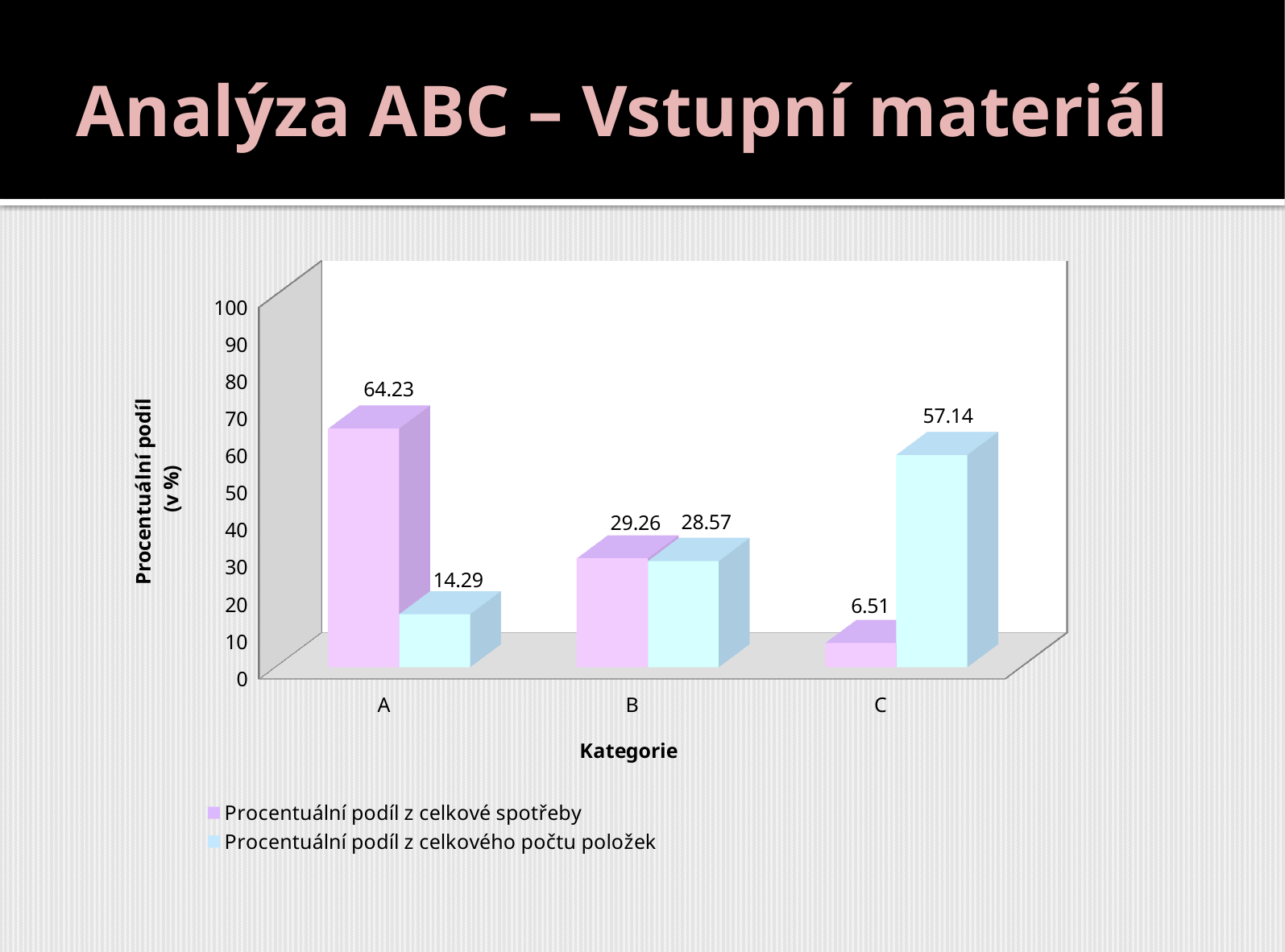
What kind of chart is shown on the slide? Bar chart What is the value of 'Procentuální podíl z celkového počtu položek' for category C? 57.14 What is the value of 'Procentuální podíl z celkové spotřeby' for category C? 6.51 What is the label of the x axis? Kategorie What is the value of 'Procentuální podíl z celkové spotřeby' for category A? 64.23 What is the difference between the two series' values for category B? 0.69 What is the value of 'Procentuální podíl z celkového počtu položek' for category A? 14.29 For category C, which series has the larger value? Procentuální podíl z celkového počtu položek How many categories are shown on the x axis? 3 How many series does the legend list? 2 Which category has the lowest value for 'Procentuální podíl z celkového počtu položek'? A Which category has the highest value for 'Procentuální podíl z celkové spotřeby'? A